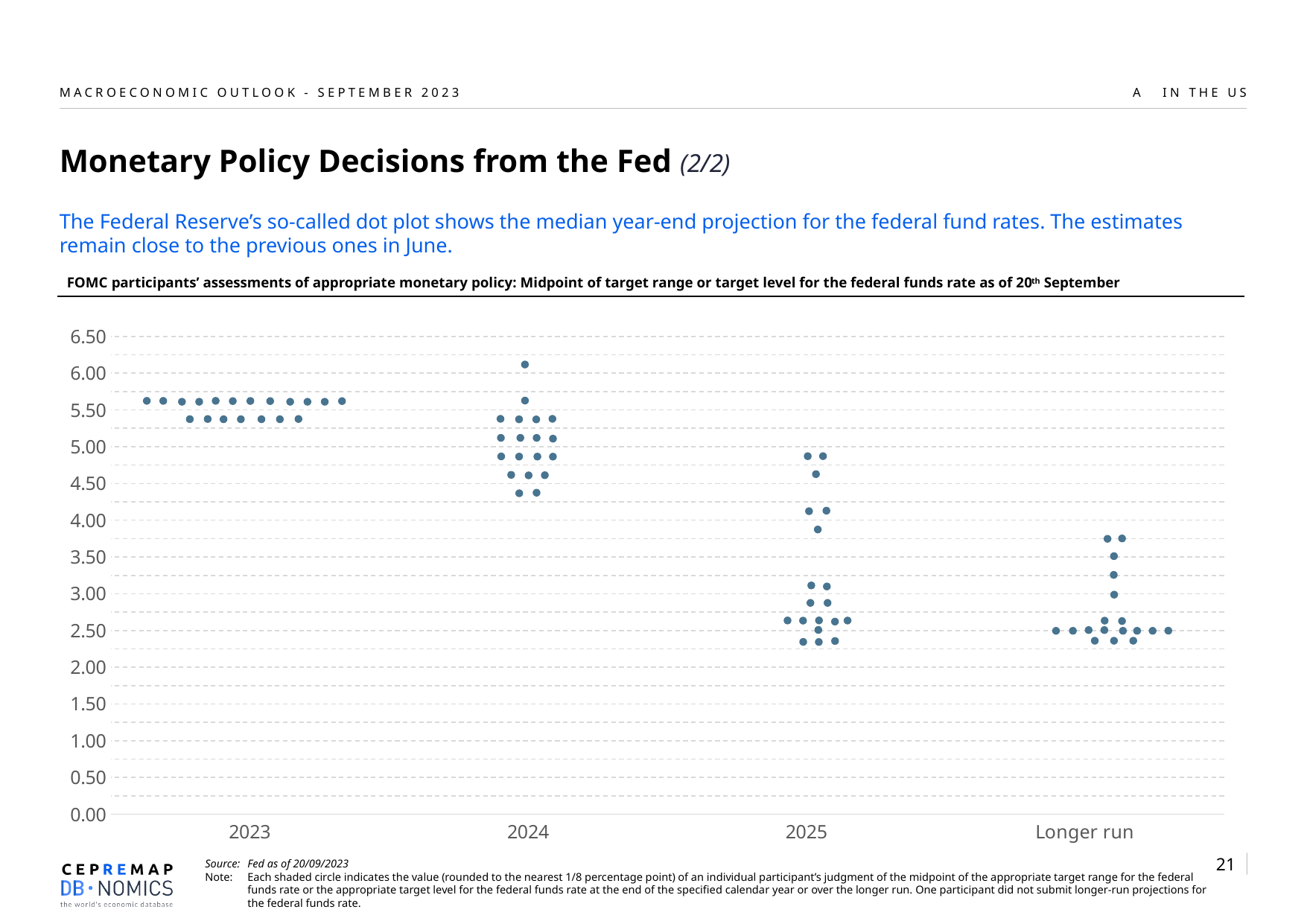
Do the projections generally rise or fall from 2023 to the Longer run? fall Is the highest dot for 2024 greater or less than 6.00? greater Which category has higher dots overall, 2023 or 2025? 2023 Which category contains the single highest dot? 2024 How many categories are shown on the x axis? 4 Are the dots for 2023 greater or less than 5.00? greater How many dots are plotted for 2023? 19 What kind of chart is shown on the slide? Dot plot (scatter chart) What are the categories on the x axis? 2023, 2024, 2025, Longer run Are all the dots for Longer run greater or less than 4.00? less What is the highest value shown on the y axis? 6.50